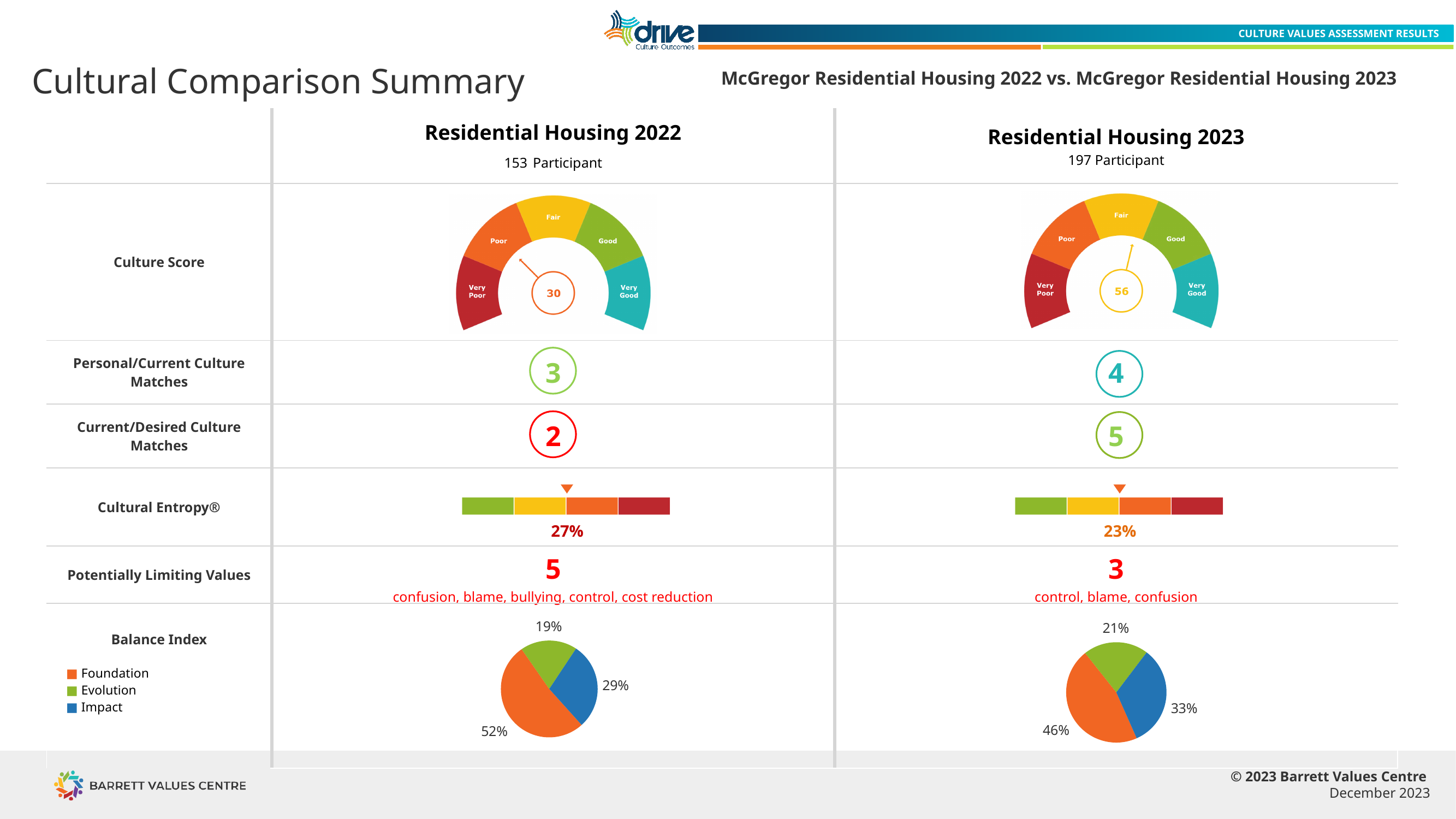
What is the Culture Score shown on the gauge for Residential Housing 2022? 30 What is the Culture Score shown on the gauge for Residential Housing 2023? 56 What is the difference between the Foundation share in the 2022 Balance Index pie and the Foundation share in the 2023 Balance Index pie? 6% Is the Evolution share larger in the 2022 Balance Index pie or the 2023 Balance Index pie? 2023 In the Balance Index pie chart for Residential Housing 2022, what share is Foundation? 52% How many slices does the Balance Index pie chart for Residential Housing 2022 have? 3 What type of chart is used for the Balance Index? Pie chart In the Balance Index pie chart for Residential Housing 2022, which category has the smallest share? Evolution What is the difference between the Culture Score for Residential Housing 2023 and Residential Housing 2022? 26 In the Balance Index pie chart for Residential Housing 2023, which category has the largest share? Foundation How many categories does the Balance Index legend list? 3 In the Balance Index pie chart for Residential Housing 2023, what share is Impact? 33%